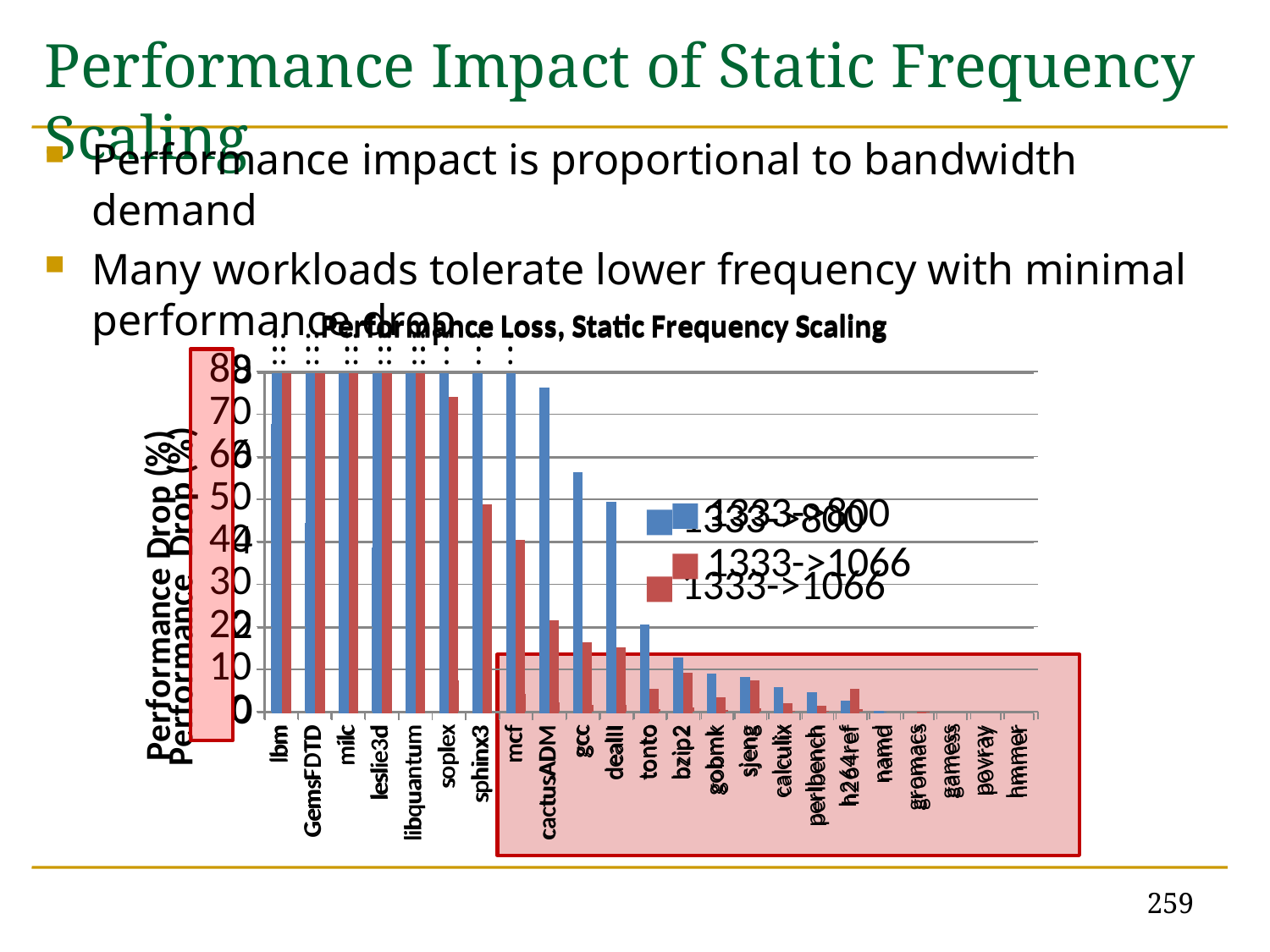
What is the title of the chart? Performance Loss, Static Frequency Scaling Do the performance drop values generally rise or fall moving from left to right along the x axis? fall What are the two series named in the chart's legend? 1333->800 and 1333->1066 Is the 1333->1066 value for cactusADM greater or less than 30? less Which has the larger 1333->800 performance drop, gcc or tonto? gcc Is the 1333->800 value for tonto greater or less than 30? less How many workloads (categories) are plotted along the x axis of the chart? 23 For sphinx3, which series has the larger performance drop, 1333->800 or 1333->1066? 1333->800 How many series does the chart's legend list? 2 What kind of chart is shown on the slide? bar chart